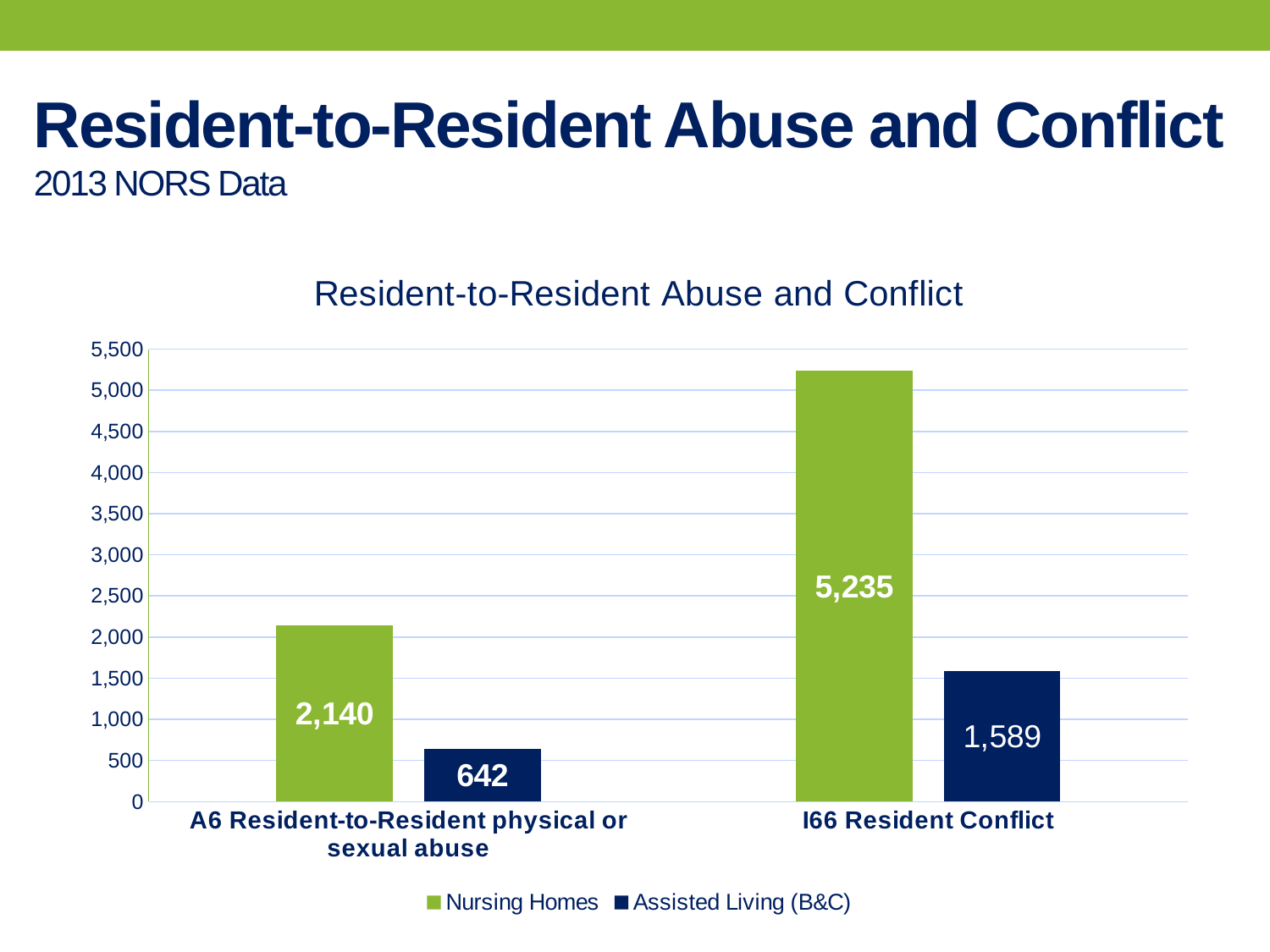
What is the Nursing Homes value for I66 Resident Conflict? 5,235 How many series does the legend list? 2 What is the Nursing Homes value for A6 Resident-to-Resident physical or sexual abuse? 2,140 What is the difference between the Nursing Homes values for I66 Resident Conflict and A6 Resident-to-Resident physical or sexual abuse? 3,095 What is the title of the chart? Resident-to-Resident Abuse and Conflict What is the Assisted Living (B&C) value for A6 Resident-to-Resident physical or sexual abuse? 642 What is the difference between the Nursing Homes and Assisted Living (B&C) values for I66 Resident Conflict? 3,646 Which category has the highest Nursing Homes value? I66 Resident Conflict Which category has the lowest Assisted Living (B&C) value? A6 Resident-to-Resident physical or sexual abuse Which is larger for A6 Resident-to-Resident physical or sexual abuse: Nursing Homes or Assisted Living (B&C)? Nursing Homes What is the Assisted Living (B&C) value for I66 Resident Conflict? 1,589 What kind of chart is shown on the slide? Bar chart